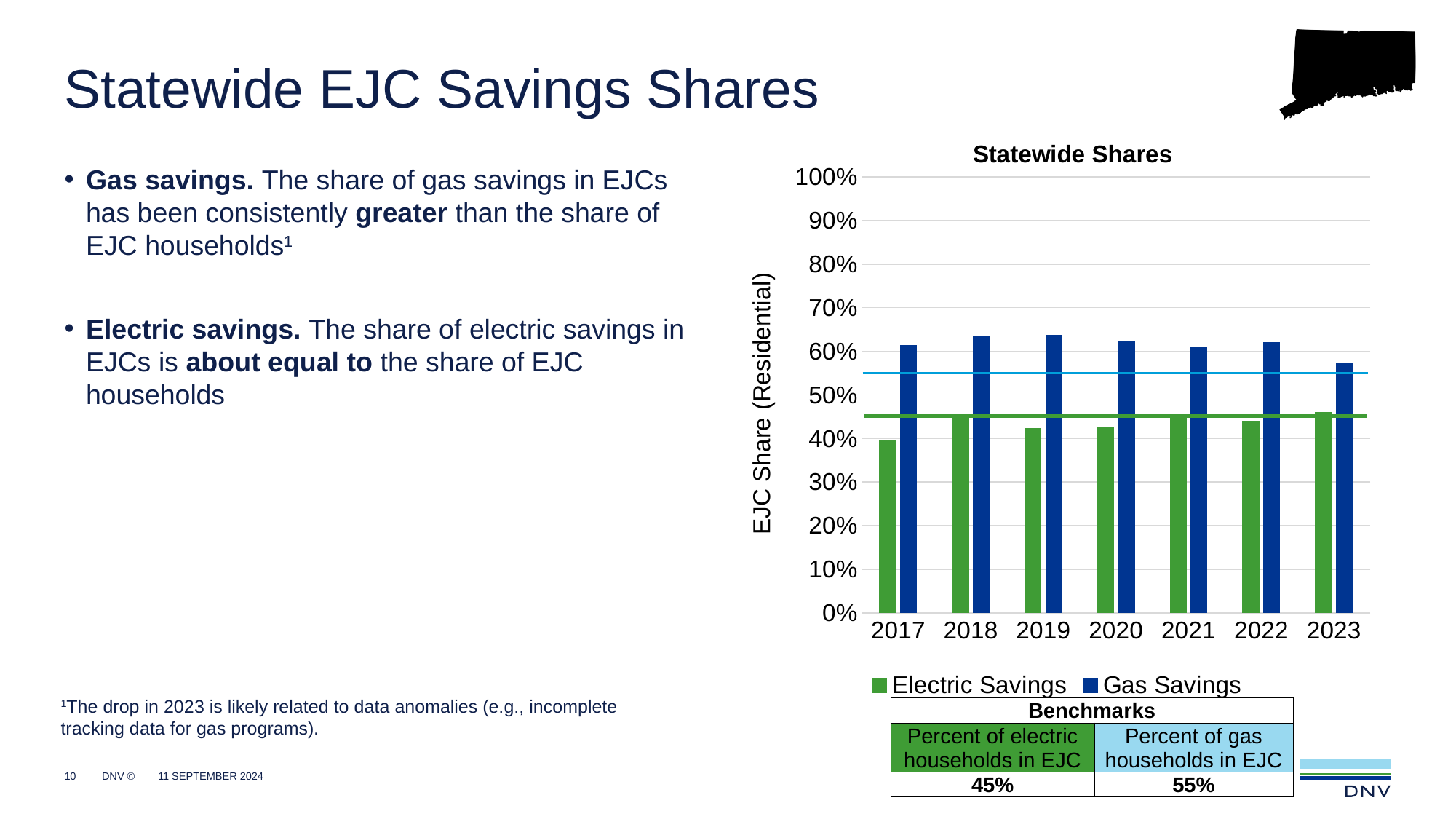
In which year is the Electric Savings share lowest? 2017 In 2020, which is larger, Electric Savings or Gas Savings? Gas Savings What is the label on the vertical axis of the chart? EJC Share (Residential) How many years are shown on the x axis of the Statewide Shares chart? 7 How many series does the legend of the Statewide Shares chart list? 2 What is the title of the chart? Statewide Shares Is the Gas Savings value for 2023 greater or less than 60%? less Is the Electric Savings value for 2019 greater or less than 50%? less In which year is the Gas Savings share lowest? 2023 What kind of chart is shown on the slide? Bar chart Is the Gas Savings value for 2017 greater or less than 50%? greater